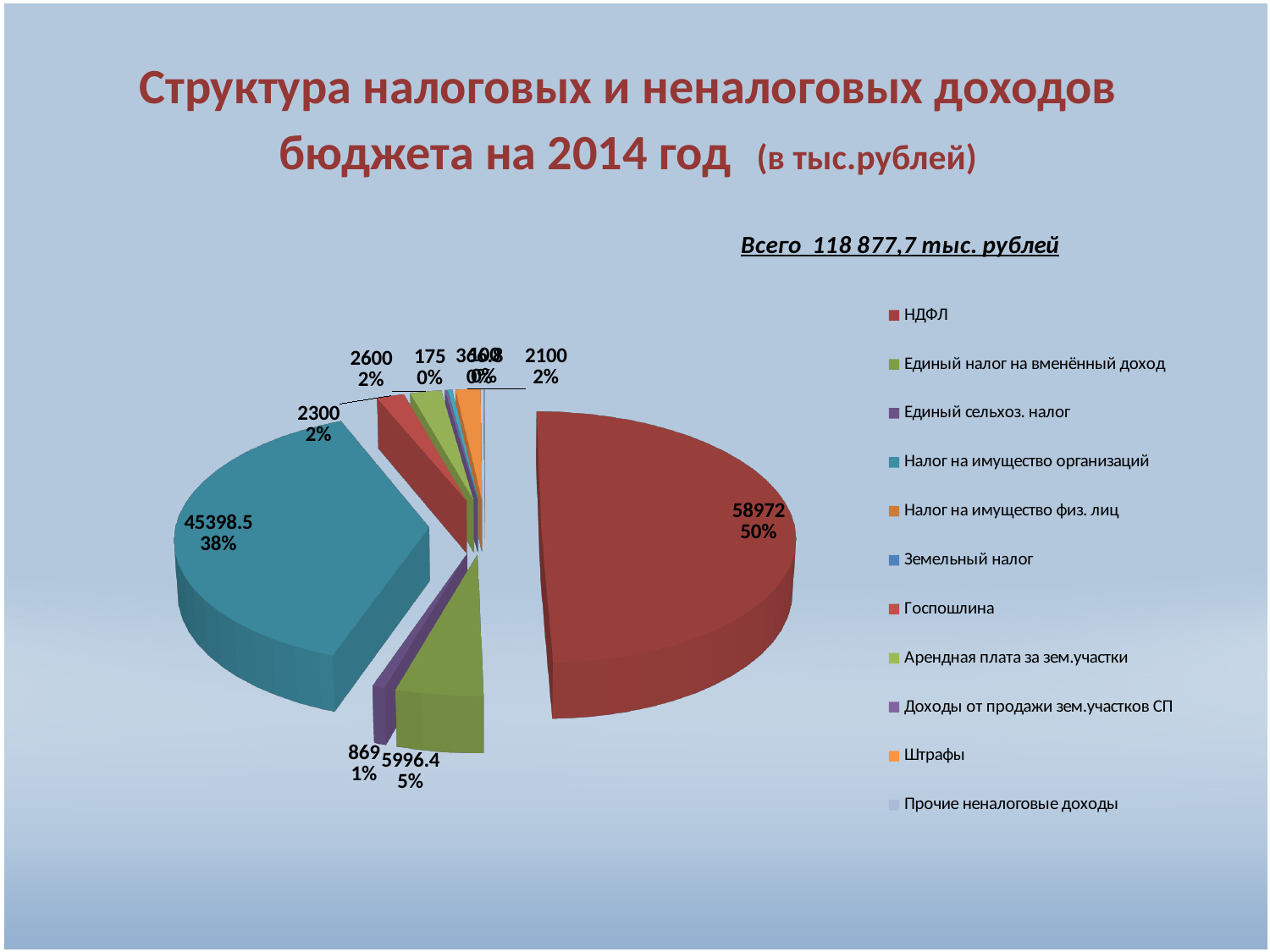
What is the value for Единый налог на вменённый доход? 5996.4 Which is larger, НДФЛ or Налог на имущество организаций? НДФЛ What is the difference between the values for НДФЛ and Налог на имущество организаций? 13573.5 What is the value for Единый сельхоз. налог? 869 How many categories does the legend list? 11 What is the value for Налог на имущество организаций? 45398.5 What share of the pie does Налог на имущество организаций represent? 38% What type of chart is shown on the slide? pie chart Which category has the largest slice of the pie? НДФЛ What share of the pie does НДФЛ represent? 50% What is the value for НДФЛ? 58972 What total amount is stated on the slide for the budget revenues? 118 877,7 тыс. рублей